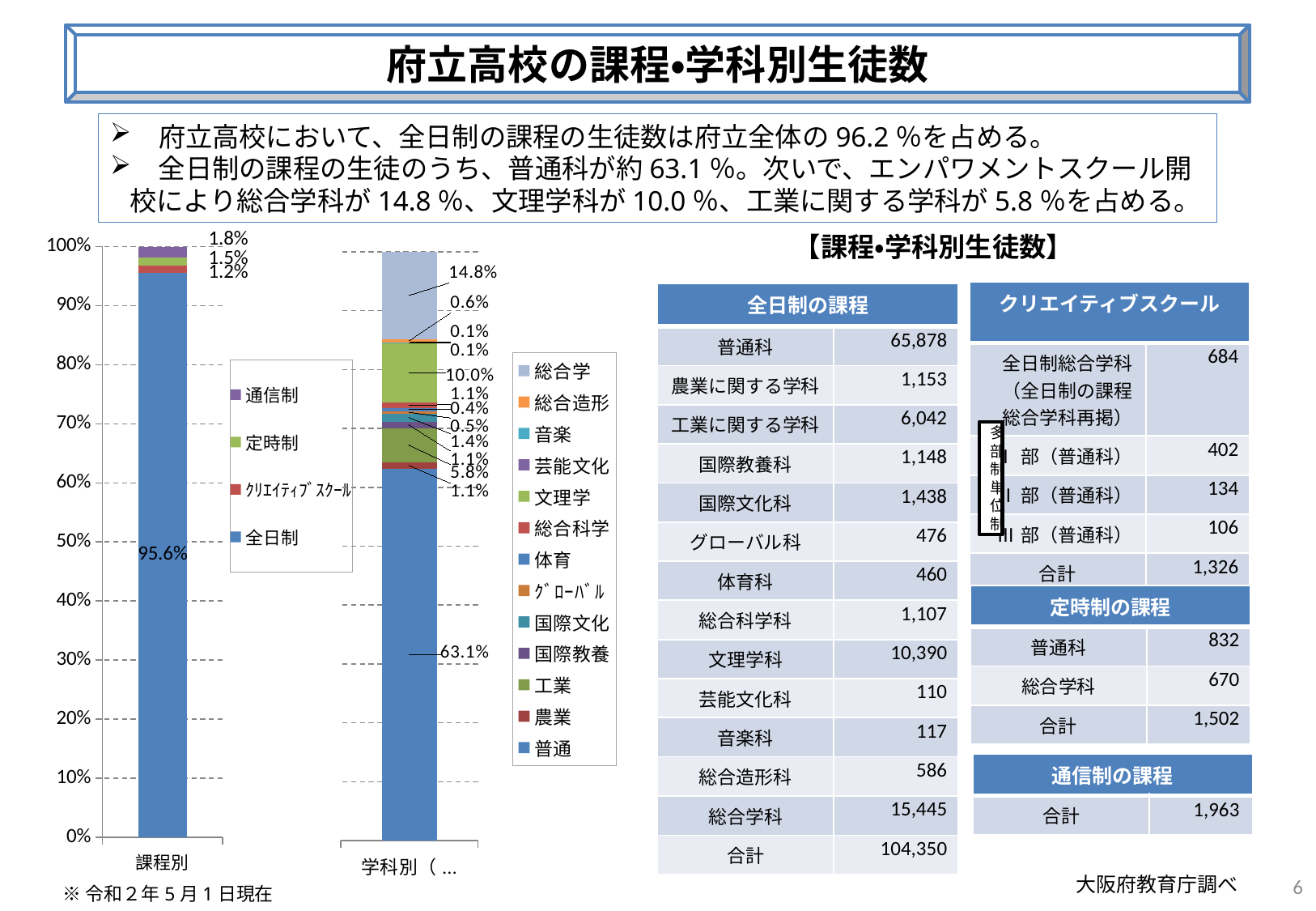
What kind of chart is shown on the left of the slide? stacked bar chart In the stacked bar chart, what percentage does 文理学 account for in the 学科別 bar? 10.0% In the stacked bar chart, what percentage does 総合学 account for in the 学科別 bar? 14.8% In the stacked bar chart, what percentage does 工業 account for in the 学科別 bar? 5.8% In the stacked bar chart, which segment is the largest in the 学科別 bar? 普通 In the stacked bar chart, what is the difference in percentage points between 総合学 (14.8%) and 文理学 (10.0%) in the 学科別 bar? 4.8 In the stacked bar chart, what percentage does 全日制 account for in the 課程別 bar? 95.6% In the stacked bar chart, which is larger in the 学科別 bar, 総合学 or 文理学? 総合学 In the stacked bar chart, is the value for 全日制 in the 課程別 bar greater or less than 90%? greater In the stacked bar chart, which segment is the largest in the 課程別 bar? 全日制 How many entries does the legend for the 課程別 bar list? 4 In the stacked bar chart, what percentage does 普通 account for in the 学科別 bar? 63.1%